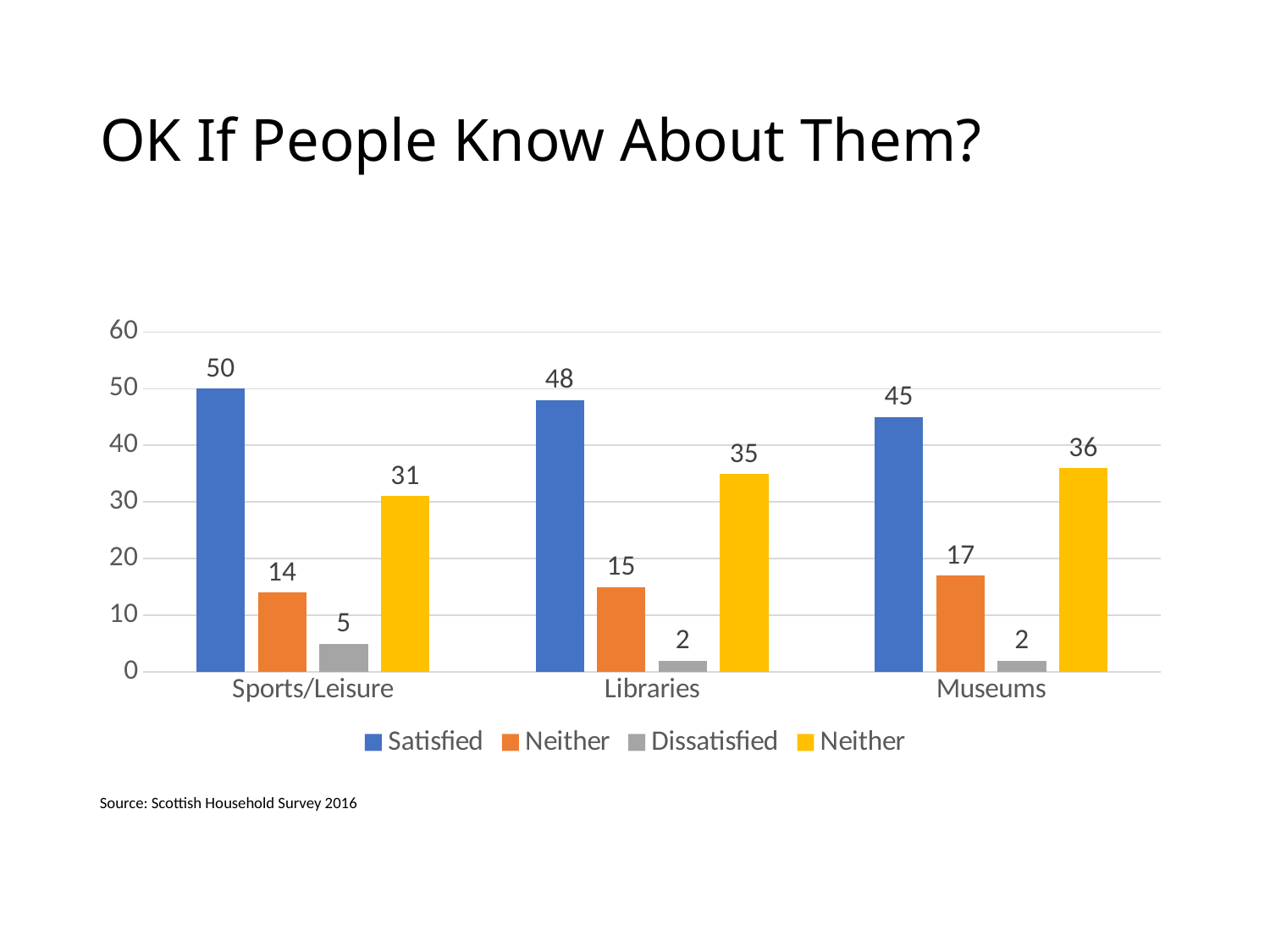
What is the difference between the Satisfied values for Sports/Leisure and Museums? 5 What is the source cited below the chart? Scottish Household Survey 2016 Which is larger, the Satisfied value for Libraries or the Satisfied value for Museums? Libraries What is the Satisfied value for Sports/Leisure? 50 What is the value of the yellow bar for Museums? 36 Which category has the highest Satisfied value? Sports/Leisure Which category has the highest Dissatisfied value? Sports/Leisure What is the Dissatisfied value for Libraries? 2 What is the value of the orange bar for Libraries? 15 What kind of chart is shown on the slide? Bar chart How many categories are shown on the x axis? 3 How many series does the legend list? 4